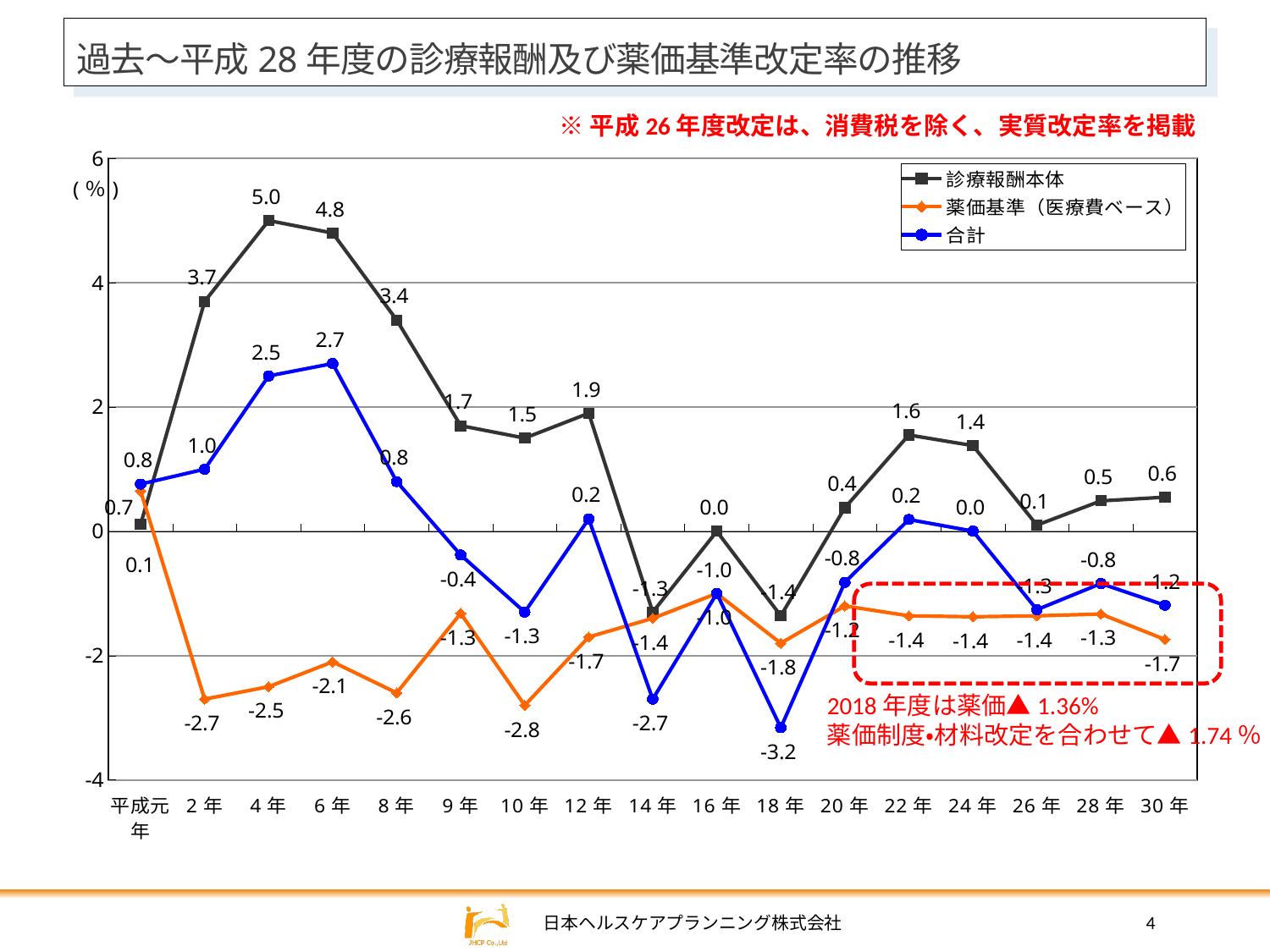
What kind of chart is shown on the slide? Line chart What is the value of 合計 in 30年? -1.2 What is the value of 薬価基準（医療費ベース） in 10年? -2.8 In which year is 合計 at its lowest? 18年 Which series is drawn in orange in the legend? 薬価基準（医療費ベース） Which year has the larger 合計 value, 4年 or 6年? 6年 What is the difference between 診療報酬本体 in 4年 (5.0) and in 6年 (4.8)? 0.2 How many years (categories) are plotted along the x axis? 17 What is the value of 診療報酬本体 in 4年? 5.0 How many series does the legend list? 3 In which year is 診療報酬本体 at its highest? 4年 Does 診療報酬本体 rise or fall from 4年 to 9年? Fall